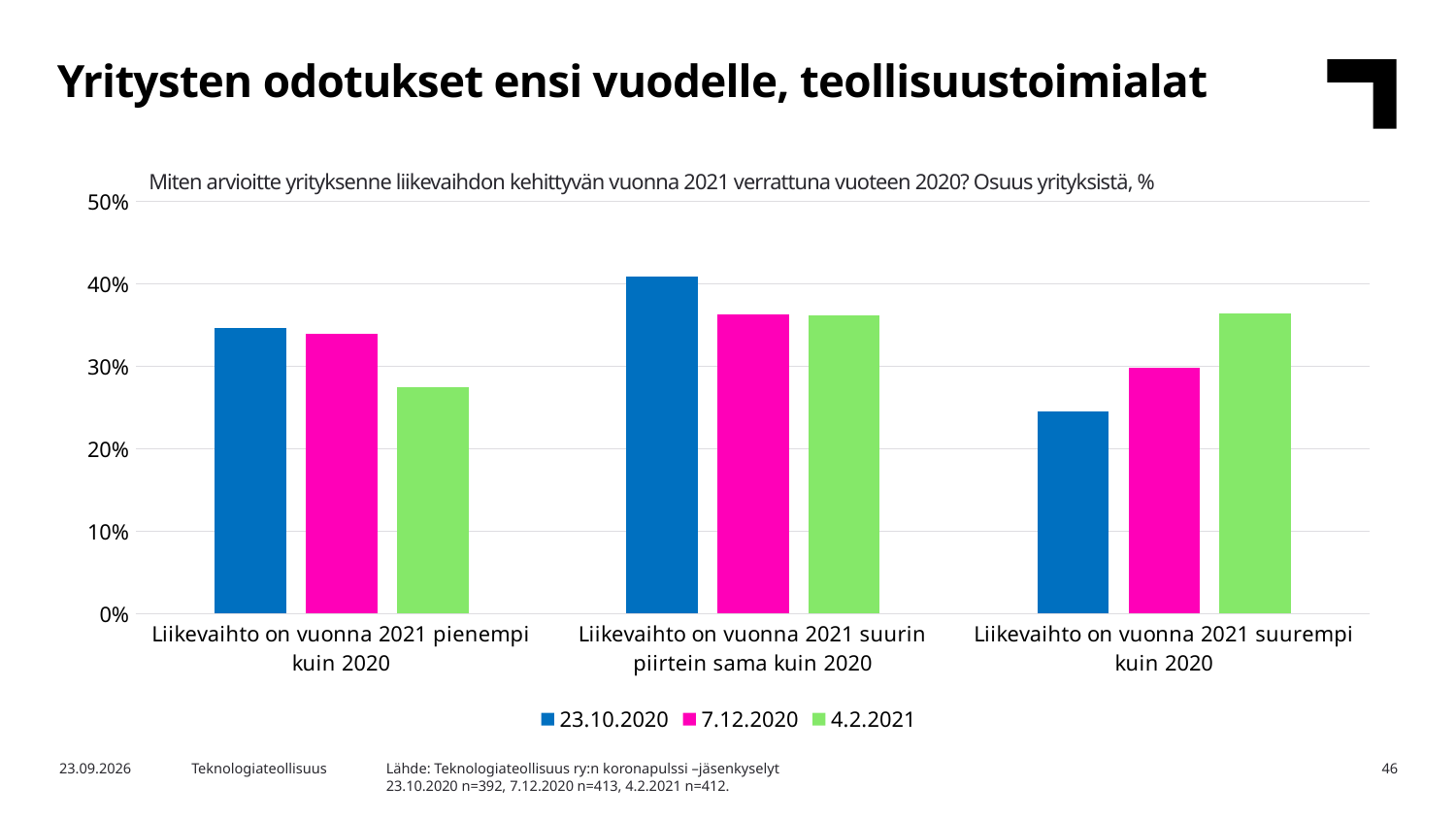
In the category 'Liikevaihto on vuonna 2021 suurin piirtein sama kuin 2020', which is larger: the 23.10.2020 value or the 7.12.2020 value? 23.10.2020 What kind of chart is shown on the slide? bar chart Is the 4.2.2021 value for 'Liikevaihto on vuonna 2021 suurempi kuin 2020' greater or less than 30%? greater How many categories are shown on the x axis? 3 Is the 23.10.2020 value for 'Liikevaihto on vuonna 2021 suurempi kuin 2020' greater or less than 30%? less Which category has the highest value for the 23.10.2020 series? Liikevaihto on vuonna 2021 suurin piirtein sama kuin 2020 Is the 4.2.2021 value for 'Liikevaihto on vuonna 2021 pienempi kuin 2020' greater or less than 30%? less Which category has the lowest value for the 23.10.2020 series? Liikevaihto on vuonna 2021 suurempi kuin 2020 Which series is shown in green in the legend? 4.2.2021 In the category 'Liikevaihto on vuonna 2021 suurempi kuin 2020', which is larger: the 23.10.2020 value or the 4.2.2021 value? 4.2.2021 How many series does the legend list? 3 Which category has the lowest value for the 4.2.2021 series? Liikevaihto on vuonna 2021 pienempi kuin 2020